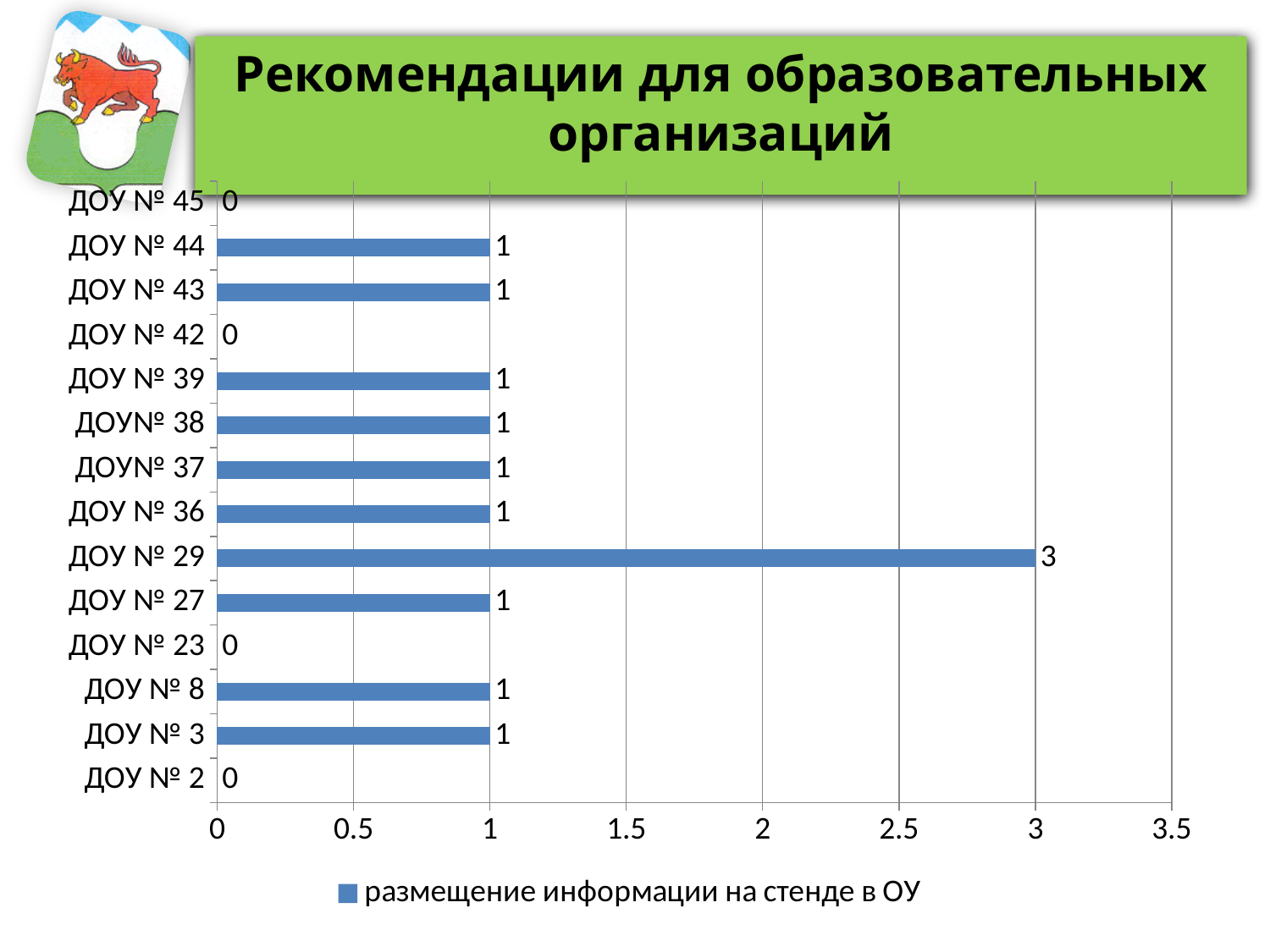
What is the difference between the values for ДОУ № 29 and ДОУ № 27? 2 Which category has the highest value? ДОУ № 29 What is the value for ДОУ № 44? 1 What is the value for ДОУ № 42? 0 Is the value for ДОУ № 29 greater or less than 2? greater Which is larger, the value for ДОУ № 29 or the value for ДОУ № 36? ДОУ № 29 What is the value for ДОУ № 29? 3 How many series does the legend list? 1 What kind of chart is shown on the slide? bar chart How many categories are shown on the chart? 14 What is the legend entry of the series shown on the chart? размещение информации на стенде в ОУ What is the value for ДОУ № 2? 0